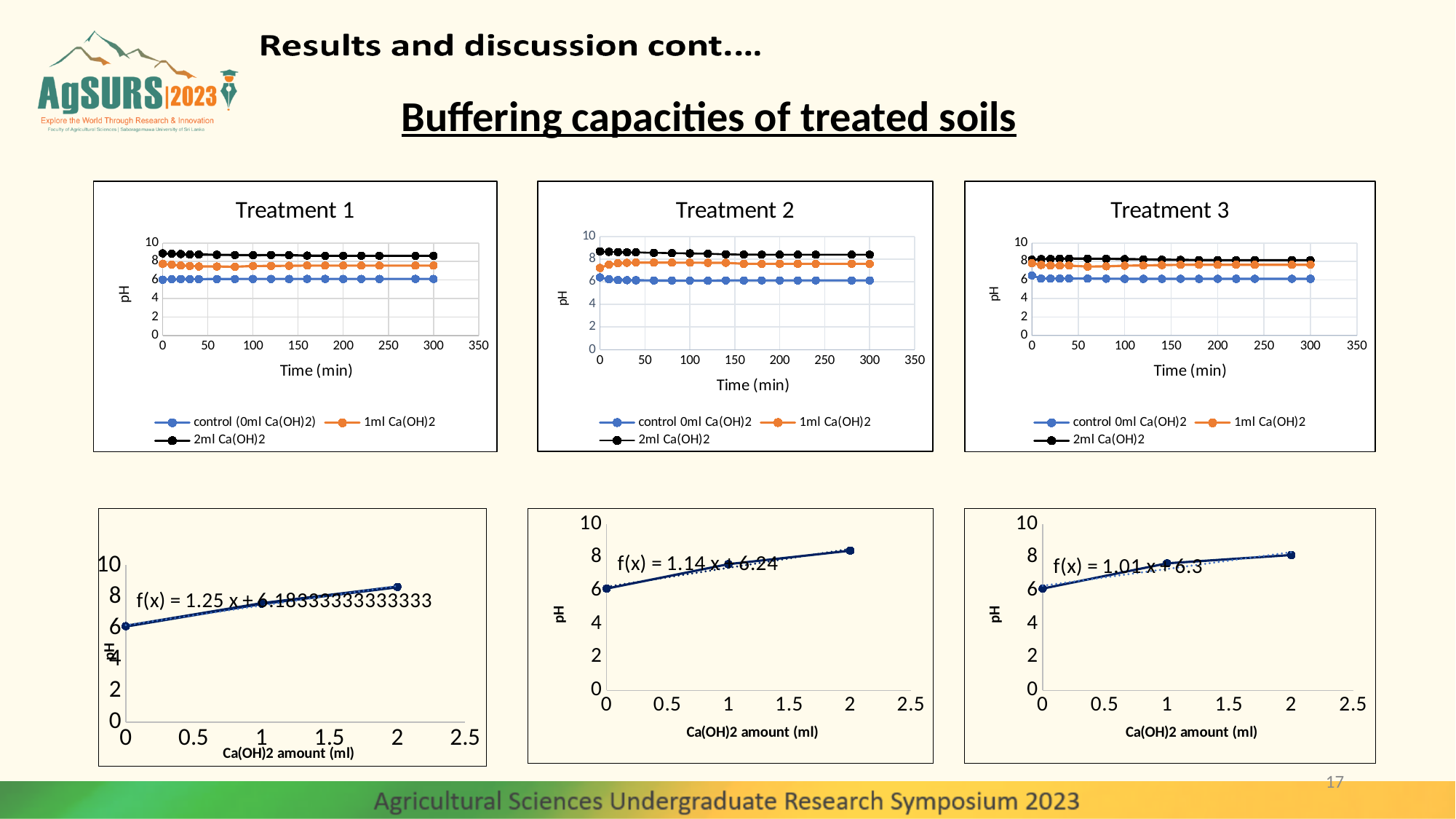
What is the x-axis label of the Treatment 1 chart? Time (min) What is the trendline equation shown on the bottom-left chart? f(x) = 1.25 x + 6.18333333333333 What kind of chart is the Treatment 1 chart? line chart What is the trendline equation shown on the bottom-middle chart? f(x) = 1.14 x + 6.24 What is the trendline equation shown on the bottom-right chart? f(x) = 1.01 x + 6.3 How many series does the legend of the Treatment 2 chart list? 3 In the Treatment 3 chart, which series has the lowest pH values? control 0ml Ca(OH)2 In the Treatment 1 chart, which series has the highest pH values? 2ml Ca(OH)2 In the bottom-middle chart, does pH rise or fall as the Ca(OH)2 amount increases? rises In the Treatment 1 chart, is the pH for 2ml Ca(OH)2 at 300 min greater or less than 8? greater In the Treatment 2 chart, is the pH for control 0ml Ca(OH)2 at 300 min greater or less than 8? less In the Treatment 3 chart, is the pH for 1ml Ca(OH)2 at 100 min greater or less than 6? greater